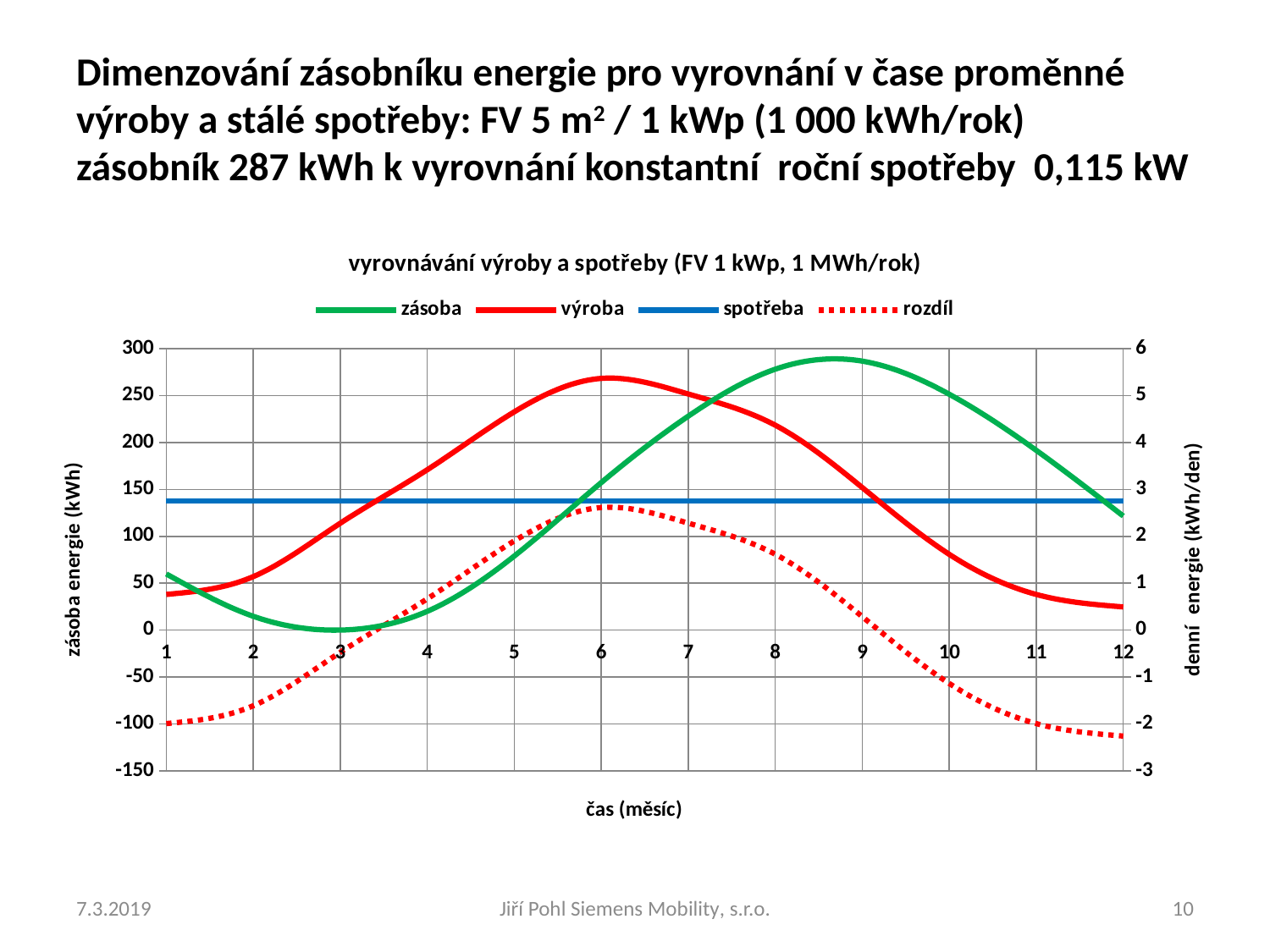
At month 1, which is larger: výroba or spotřeba? spotřeba In which month does the zásoba series reach its lowest value? 3 Which series is drawn as a dotted line in the chart? rozdíl In which month does the výroba series reach its highest value? 6 Is the výroba value at month 12 greater or less than 1 kWh/den? less Does the zásoba series rise or fall from month 9 to month 12? fall What kind of chart is shown on the slide? line chart Is the zásoba value at month 9 greater or less than 250 kWh? greater Is the rozdíl value at month 1 greater or less than -1 kWh/den? less How many series does the chart legend list? 4 What is the title of the chart? vyrovnávání výroby a spotřeby (FV 1 kWp, 1 MWh/rok) How many months are shown along the x axis of the chart? 12